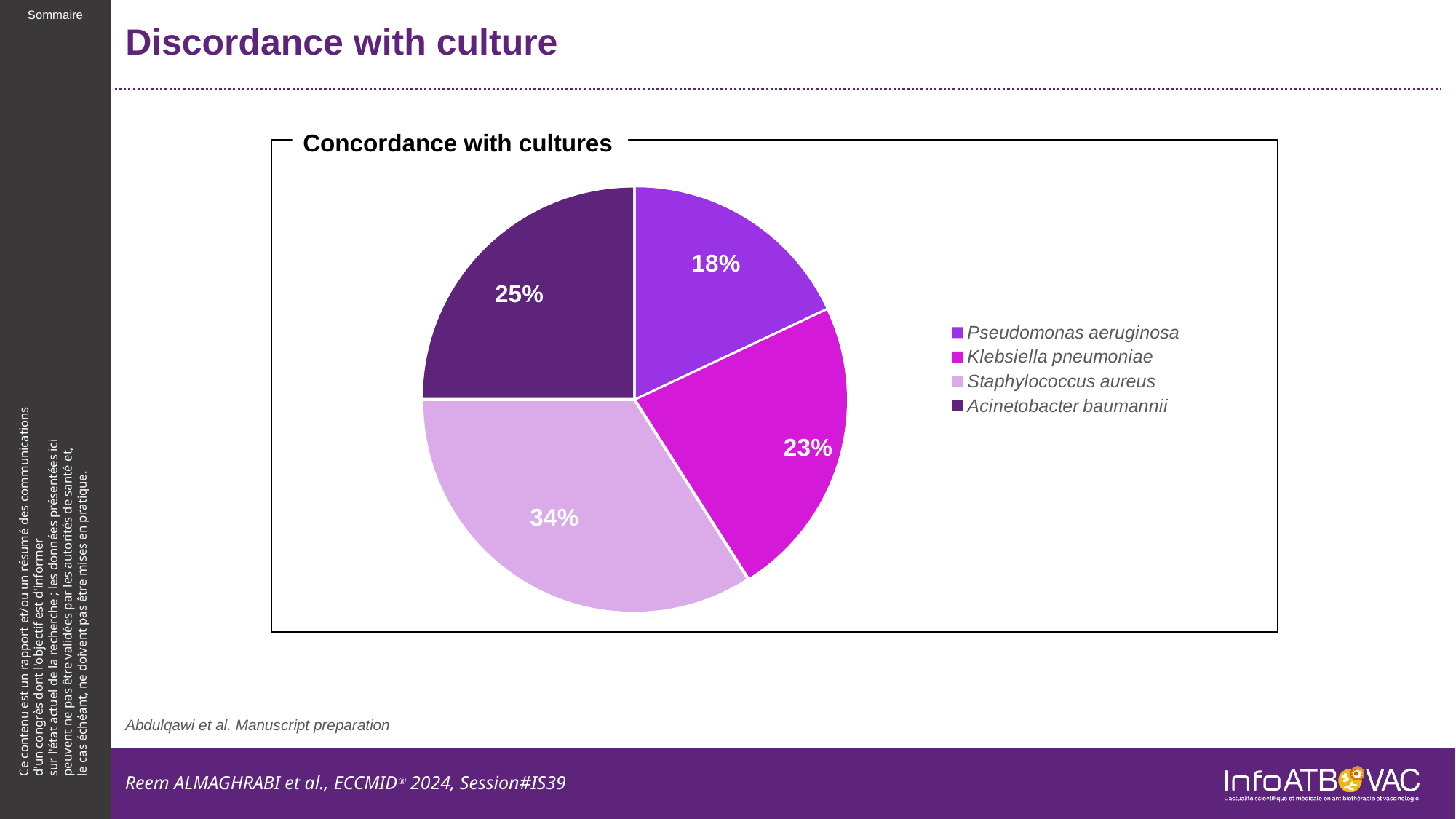
How many slices does the pie chart have? 4 What percentage of the pie is Acinetobacter baumannii? 25% Which organism has the smallest share of the pie? Pseudomonas aeruginosa Which organism has the largest share of the pie? Staphylococcus aureus Which has a larger share, Acinetobacter baumannii or Klebsiella pneumoniae? Acinetobacter baumannii What type of chart is shown on the slide? pie chart What percentage of the pie is Klebsiella pneumoniae? 23% What percentage of the pie is Staphylococcus aureus? 34% What is the difference in percentage points between Staphylococcus aureus and Pseudomonas aeruginosa? 16 What is the title of the chart? Concordance with cultures What percentage of the pie is Pseudomonas aeruginosa? 18% How many entries does the legend list? 4